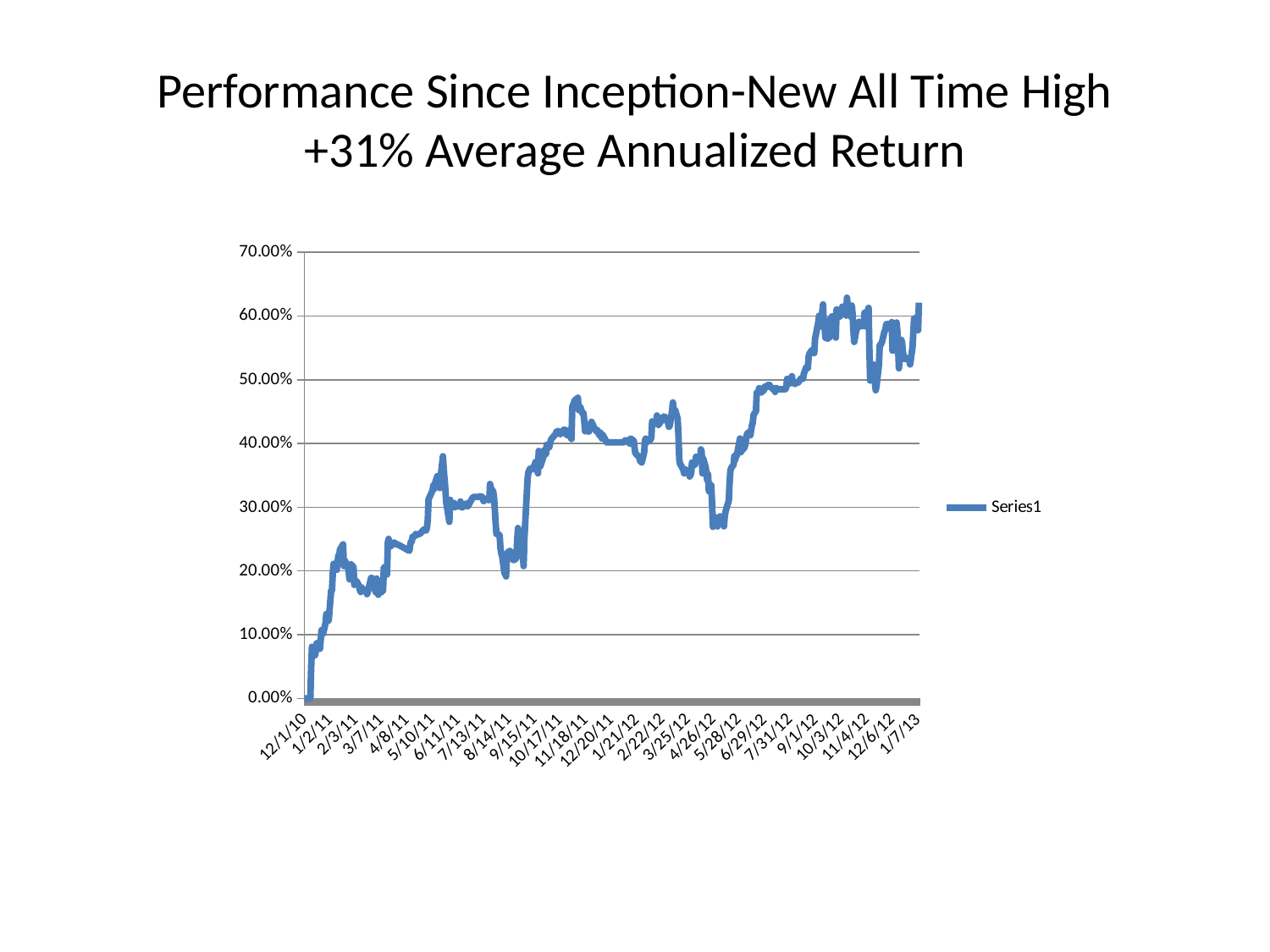
Is the value at 1/7/13 greater or less than 50.00%? greater Which is larger, the value at 1/7/13 or the value at 12/1/10? 1/7/13 What is the title of the slide containing the chart? Performance Since Inception-New All Time High +31% Average Annualized Return What kind of chart is shown on the slide? line chart Overall, do the values rise or fall from 12/1/10 to 1/7/13? rise How many series does the legend list? 1 What is the name of the series shown in the legend? Series1 Is the value at 11/18/11 greater or less than 40.00%? greater Is the value at 12/6/12 greater or less than 50.00%? greater